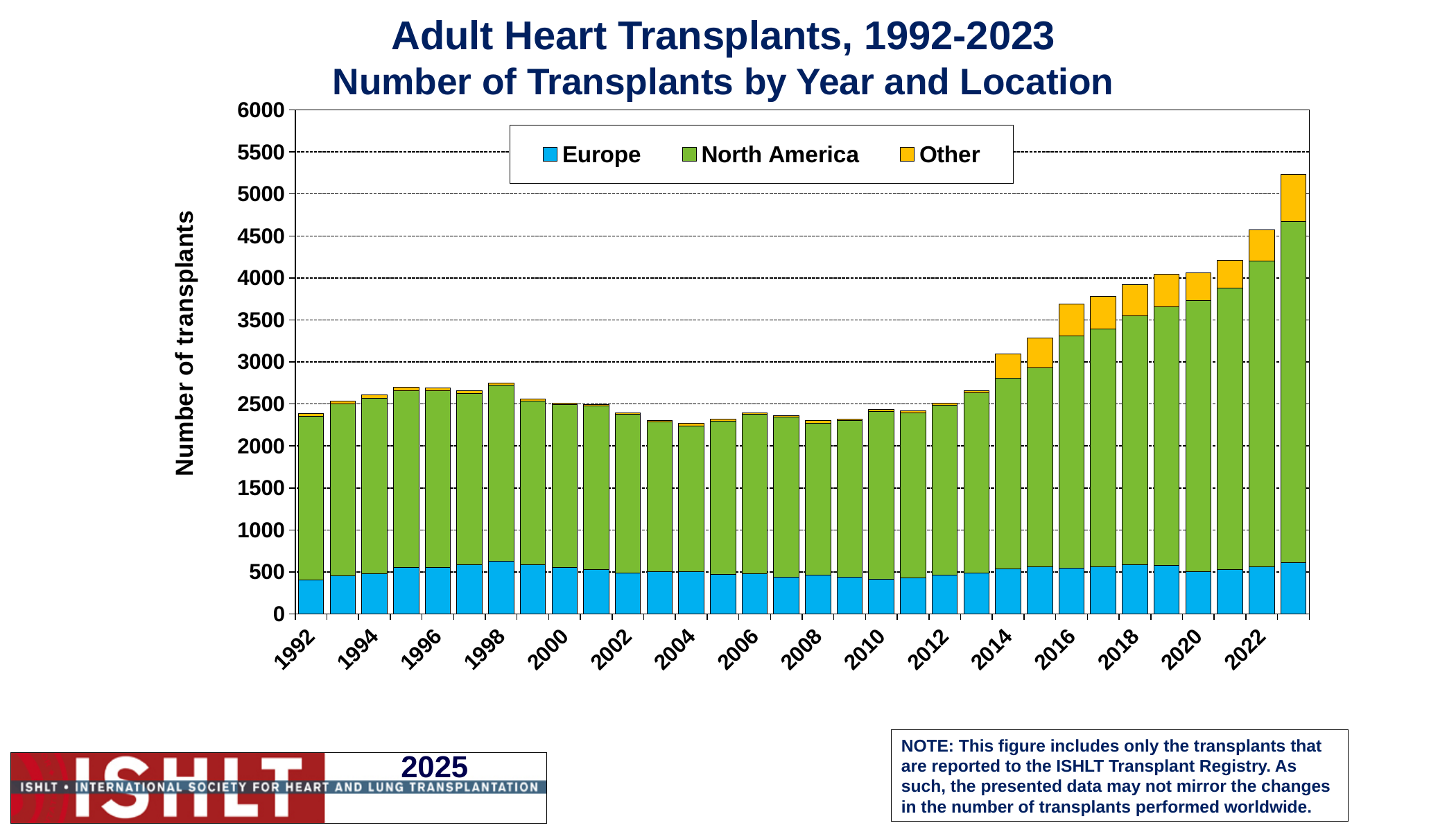
What is the label on the y axis of the chart? Number of transplants Is the total number of transplants in 1992 greater or less than 2500? less Is the total number of transplants in 2016 greater or less than 3500? greater Which year has the highest total number of transplants? 2023 How many series does the legend list? 3 Which year has the larger total number of transplants, 2020 or 2010? 2020 Is the total number of transplants in 2010 greater or less than 2500? less Which series is shown in green in the chart? North America How many years (bars) are plotted in the chart? 32 What kind of chart is shown on the slide? Stacked bar chart Do the total numbers of transplants rise or fall from 2013 to 2023? rise